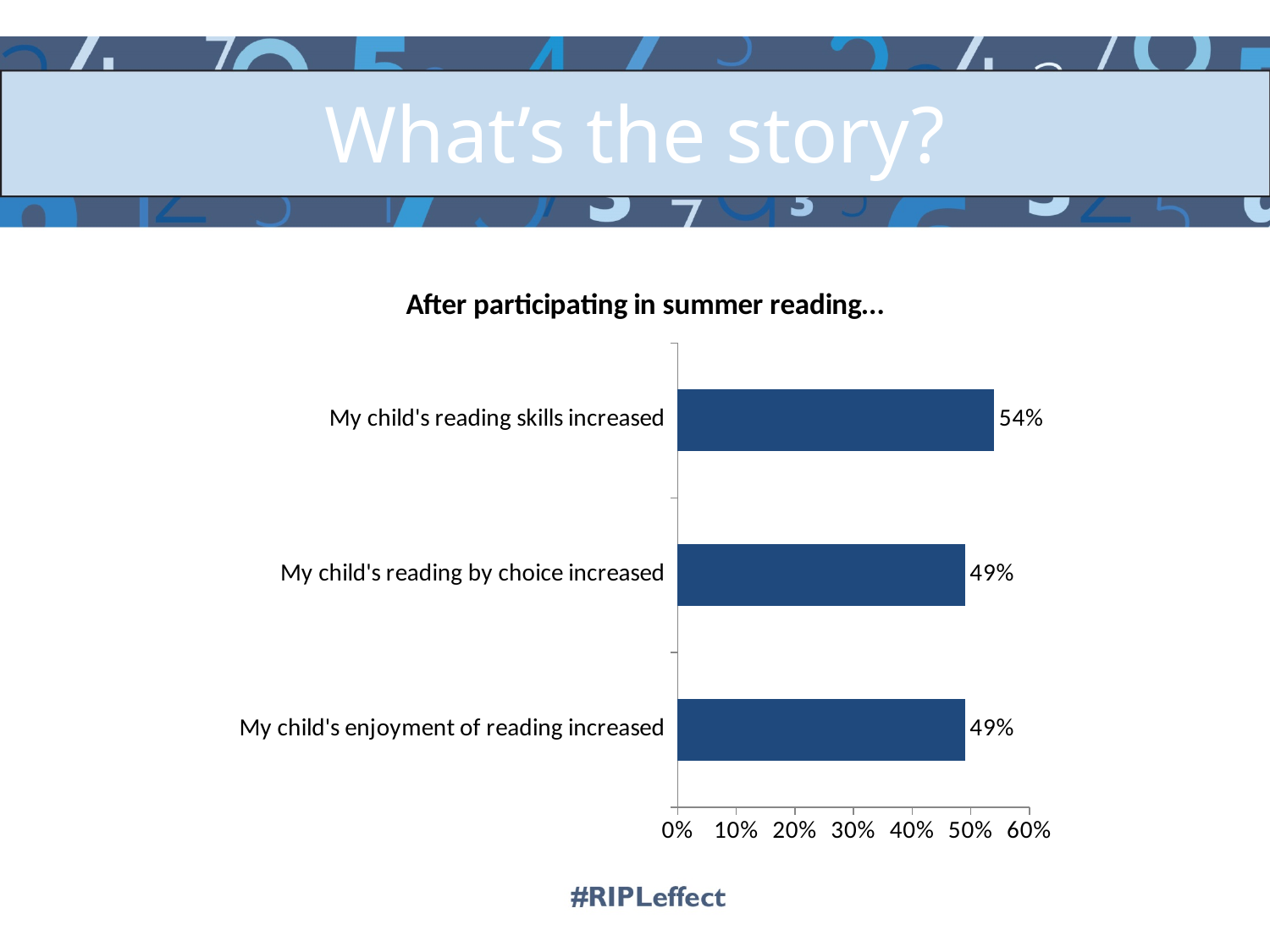
What kind of chart is shown on the slide? Bar chart What is the value for "My child's enjoyment of reading increased"? 49% Which category has the highest value? My child's reading skills increased What is the difference between the value for "My child's reading skills increased" and the value for "My child's reading by choice increased"? 5% What is the value for "My child's reading skills increased"? 54% How many categories are shown in the chart? 3 Is the value for "My child's enjoyment of reading increased" greater or less than 40%? greater Is the value for "My child's reading skills increased" greater or less than 50%? greater What is the title of the chart? After participating in summer reading… Which is larger: the value for "My child's reading skills increased" or the value for "My child's enjoyment of reading increased"? My child's reading skills increased What is the value for "My child's reading by choice increased"? 49% What is the highest value shown on the x axis? 60%